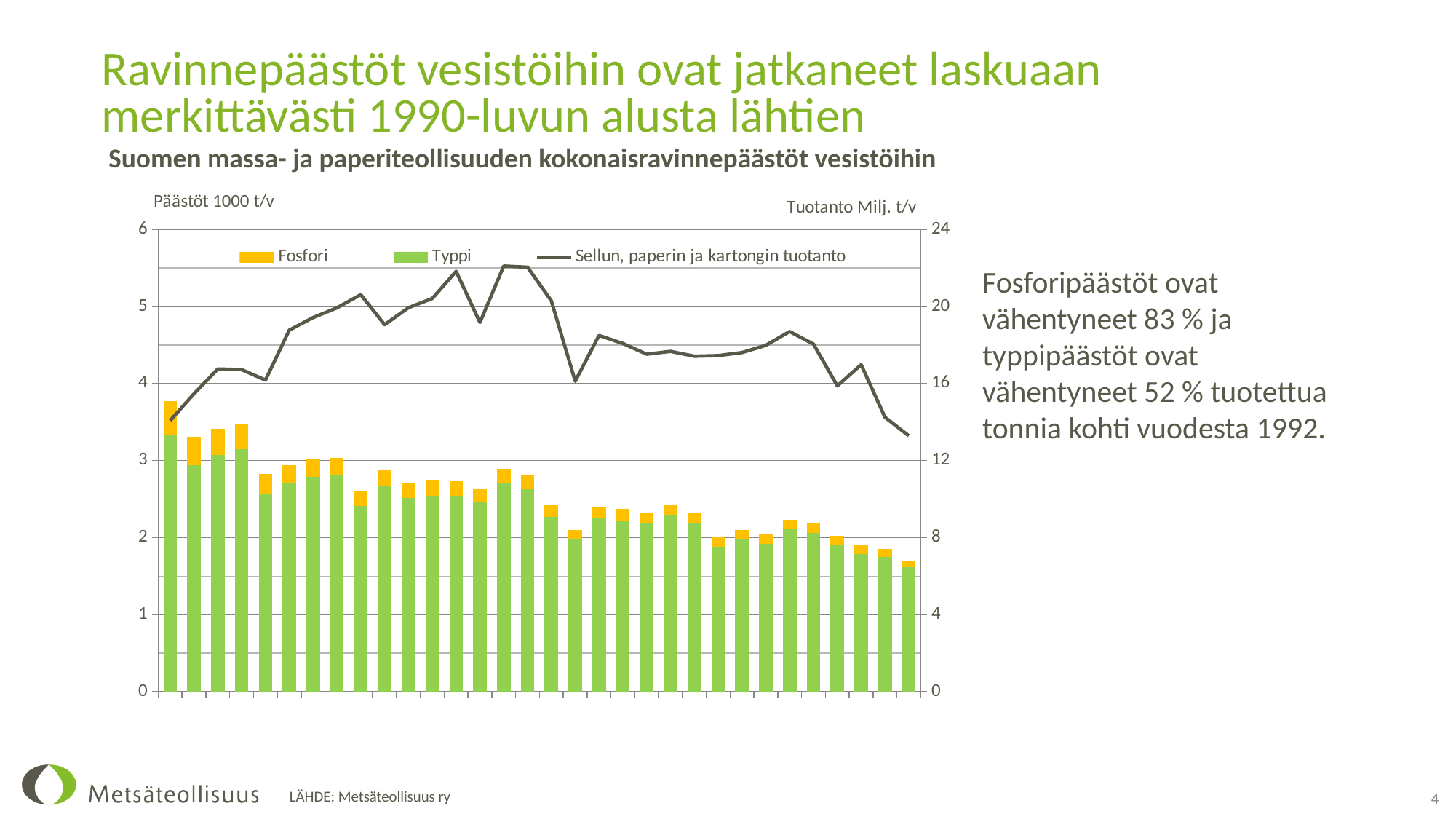
Is the total of the rightmost bar greater or less than 2 on the left axis? less Which is larger in the leftmost bar, the Typpi portion or the Fosfori portion? Typpi Is the total of the leftmost bar greater or less than 3.5 on the left axis? greater How many series does the chart legend list? 3 What kind of chart is shown on the slide? A stacked bar chart combined with a line chart Which series are listed in the chart legend? Fosfori, Typpi, Sellun, paperin ja kartongin tuotanto Which bar has the highest total emissions, the leftmost or the rightmost? The leftmost Do the stacked bars (total emissions) generally rise or fall from left to right along the x axis? Fall What colour represents Fosfori in the chart? Yellow Which bar has the lowest total emissions? The rightmost bar Is the final value of the production line greater or less than 16 on the right axis? less